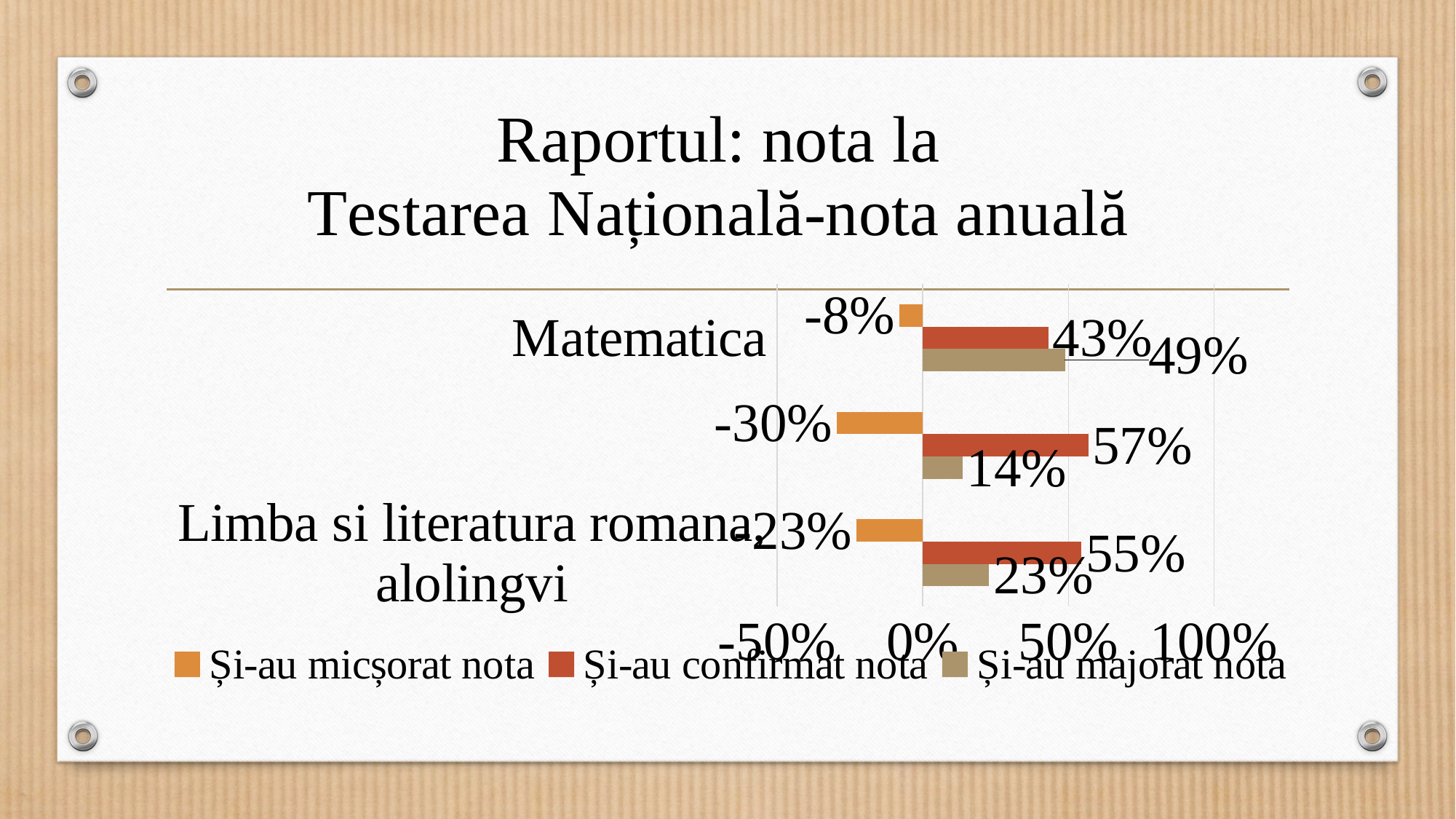
What is the value for Și-au micșorat nota for Limba si literatura romana alolingvi? -23% Which series has the highest value for Limba si literatura romana alolingvi? Și-au confirmat nota What is the value for Și-au micșorat nota for Matematica? -8% What colour represents Și-au micșorat nota in the legend? Orange What is the value for Și-au confirmat nota for Limba si literatura romana alolingvi? 55% How many series does the legend list? 3 What is the value for Și-au confirmat nota for Matematica? 43% Which has the larger Și-au majorat nota value: Matematica or Limba si literatura romana alolingvi? Matematica What is the value for Și-au majorat nota for Matematica? 49% For Matematica, what is the difference between the Și-au majorat nota value and the Și-au confirmat nota value? 6 percentage points What is the value for Și-au majorat nota for Limba si literatura romana alolingvi? 23% What kind of chart is shown on the slide? Bar chart